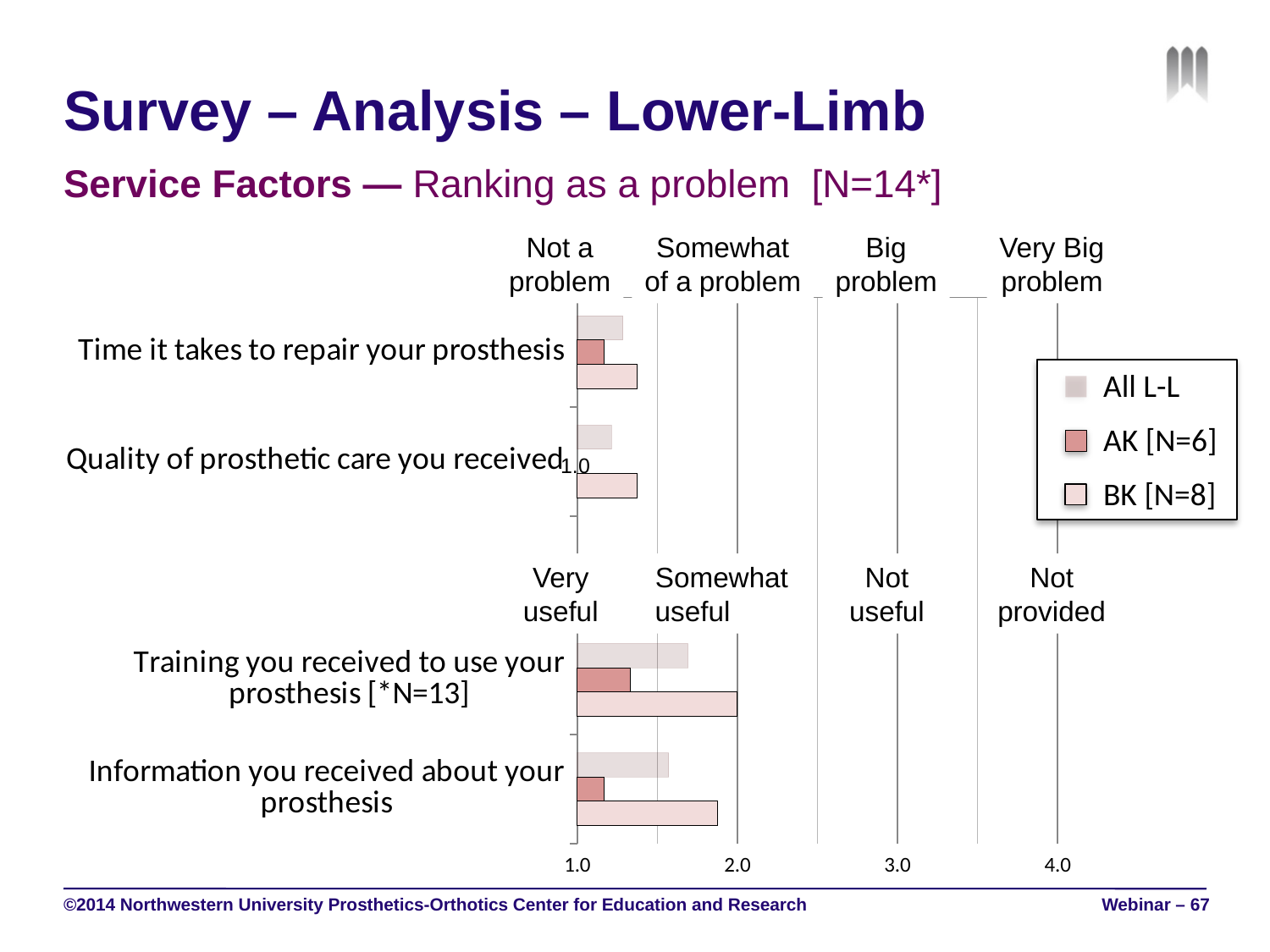
What kind of chart is shown on the slide? bar chart How many series does the legend list? 3 For 'Information you received about your prosthesis', which is larger, the AK value or the BK value? BK Is the BK value for 'Training you received to use your prosthesis' greater or less than 3.0? less For 'Time it takes to repair your prosthesis', which is larger, the AK value or the BK value? BK Is the AK value for 'Training you received to use your prosthesis' greater or less than 2.0? less Is the BK value for 'Time it takes to repair your prosthesis' greater or less than 2.0? less For 'Training you received to use your prosthesis', which is larger, the AK value or the BK value? BK How many categories (survey items) are plotted on the chart? 4 Which series does the legend list with N=6? AK What is the highest tick value shown on the horizontal axis? 4.0